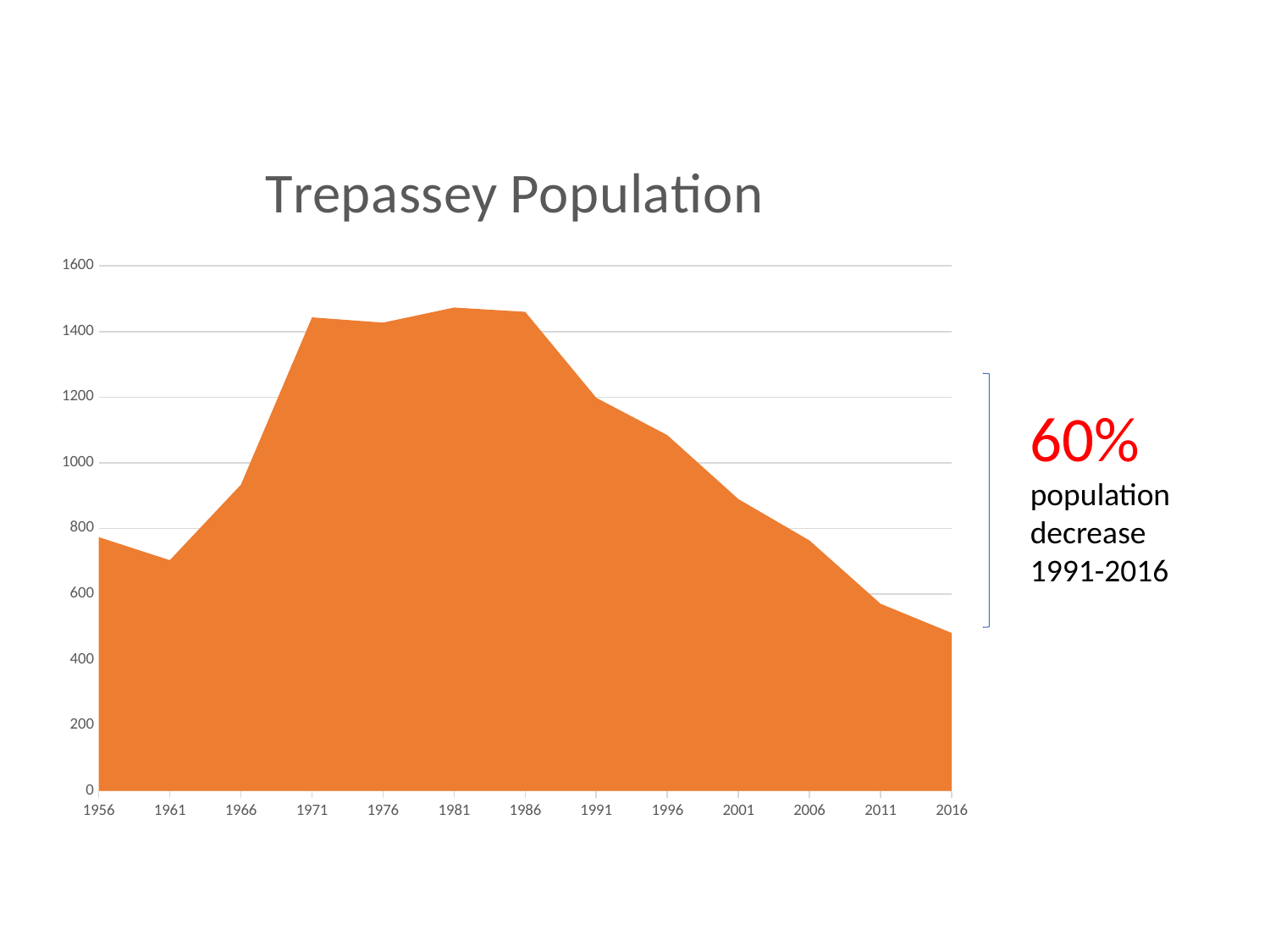
Is the population value for 2016 greater or less than 600? less Do the population values rise or fall from 1986 to 2016? fall What percentage population decrease for 1991-2016 is annotated beside the chart? 60% What is the title of the chart? Trepassey Population Is the population value for 1971 greater or less than 1400? greater Is the population value for 2006 greater or less than 800? less What kind of chart is shown on the slide? Area chart Which year has the larger population value, 1961 or 1971? 1971 Which year has the lowest population value on the chart? 2016 How many years are marked along the x axis of the chart? 13